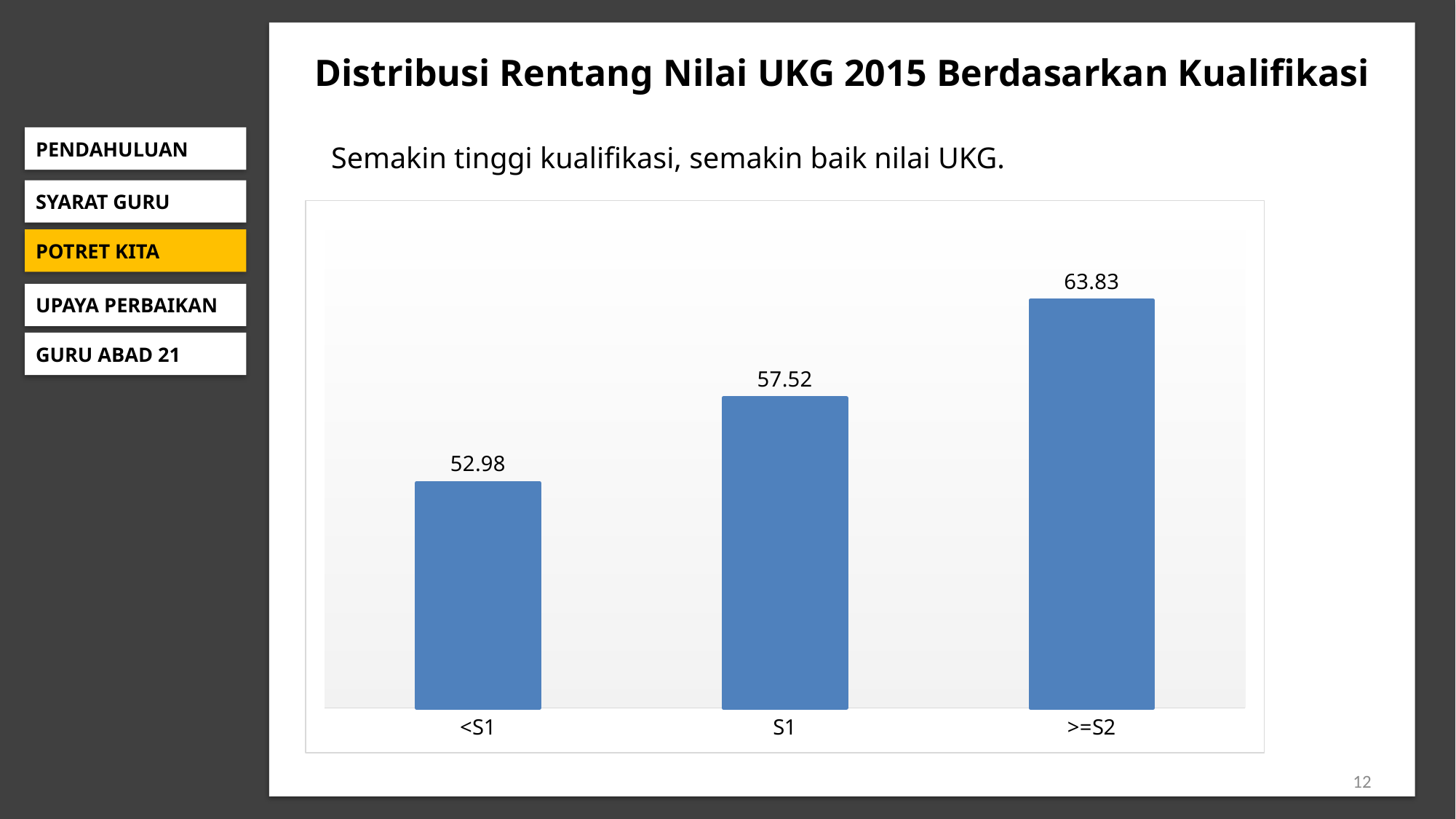
What kind of chart is shown on the slide? Bar chart Which category has the highest value? >=S2 What is the difference between the values for S1 and <S1? 4.54 What is the value for the <S1 category? 52.98 Do the values rise or fall from <S1 to >=S2 along the x axis? Rise What is the value for the >=S2 category? 63.83 What is the value for the S1 category? 57.52 Which category has the lowest value? <S1 Which is larger, the value for S1 or the value for >=S2? >=S2 What is the title of the slide containing the chart? Distribusi Rentang Nilai UKG 2015 Berdasarkan Kualifikasi How many categories are shown on the x axis? 3 What is the difference between the values for >=S2 and <S1? 10.85